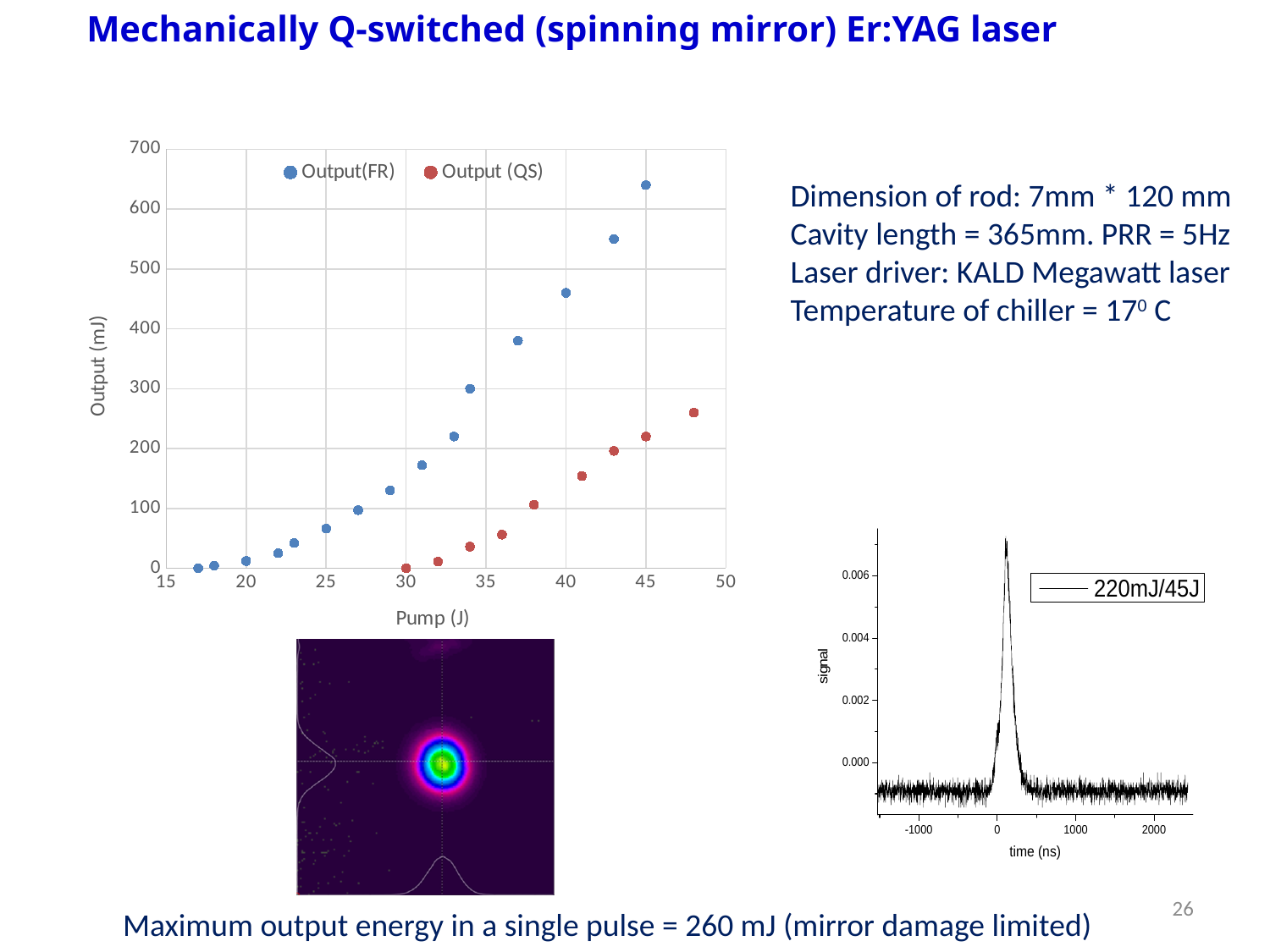
In the Output vs Pump chart, which series reaches the highest output value? Output(FR) In the Output vs Pump chart, at a pump of 45 J, which series has the higher output: Output(FR) or Output (QS)? Output(FR) In the Output vs Pump chart, is the Output(FR) value at a pump of 40 J greater or less than 400? greater In the pulse signal chart at the lower right, what label does the legend show? 220mJ/45J In the Output vs Pump chart, what kind of chart is used to plot the data? scatter chart In the Output vs Pump chart, does the Output(FR) series rise or fall as the pump energy increases? rise In the Output vs Pump chart, how many data points are plotted for the Output (QS) series? 9 In the Output vs Pump chart, is the Output(FR) value at a pump of 45 J greater or less than 600? greater In the Output vs Pump chart, what are the two series named in the legend? Output(FR) and Output (QS) In the Output vs Pump chart, how many series does the legend list? 2 In the Output vs Pump chart, is the Output (QS) value at a pump of 48 J greater or less than 300? less